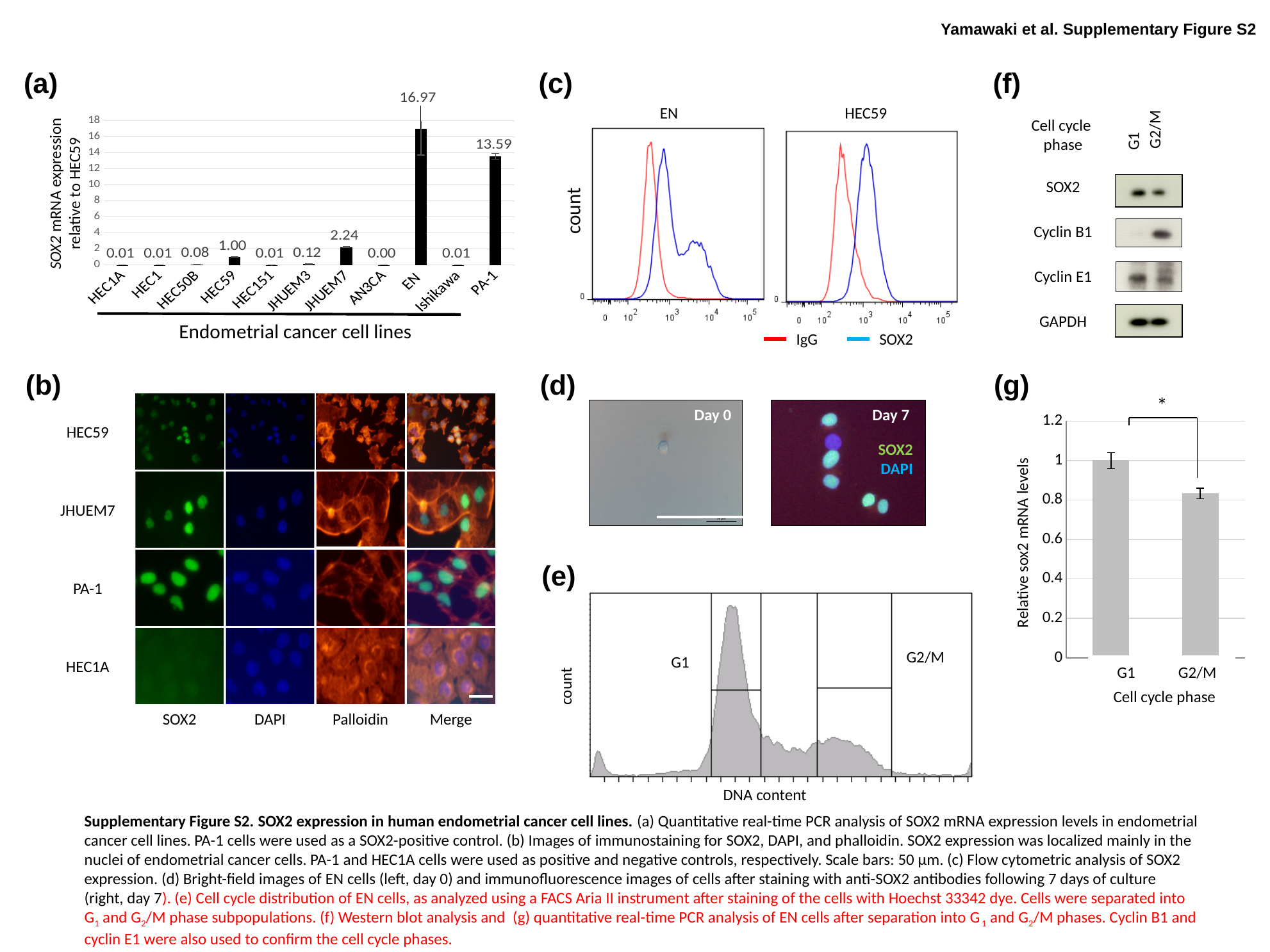
In chart (g), which cell cycle phase has the higher relative sox2 mRNA level, G1 or G2/M? G1 In chart (a), what is the SOX2 mRNA expression value for PA-1? 13.59 In chart (a), which cell line has the lowest SOX2 mRNA expression value? AN3CA In chart (g), is the value for G2/M greater or less than 1? less In chart (a), what is the value shown for JHUEM7? 2.24 In chart (a), which has a larger value, JHUEM7 or HEC59? JHUEM7 How many series does the legend of chart (c) list? 2 How many endometrial cancer cell lines are shown on the x axis of chart (a)? 11 In chart (a), what is the difference between the values for EN and PA-1? 3.38 In chart (a), which cell line has the highest SOX2 mRNA expression? EN What kind of chart is chart (a)? bar chart In chart (a), what is the SOX2 mRNA expression value for EN? 16.97